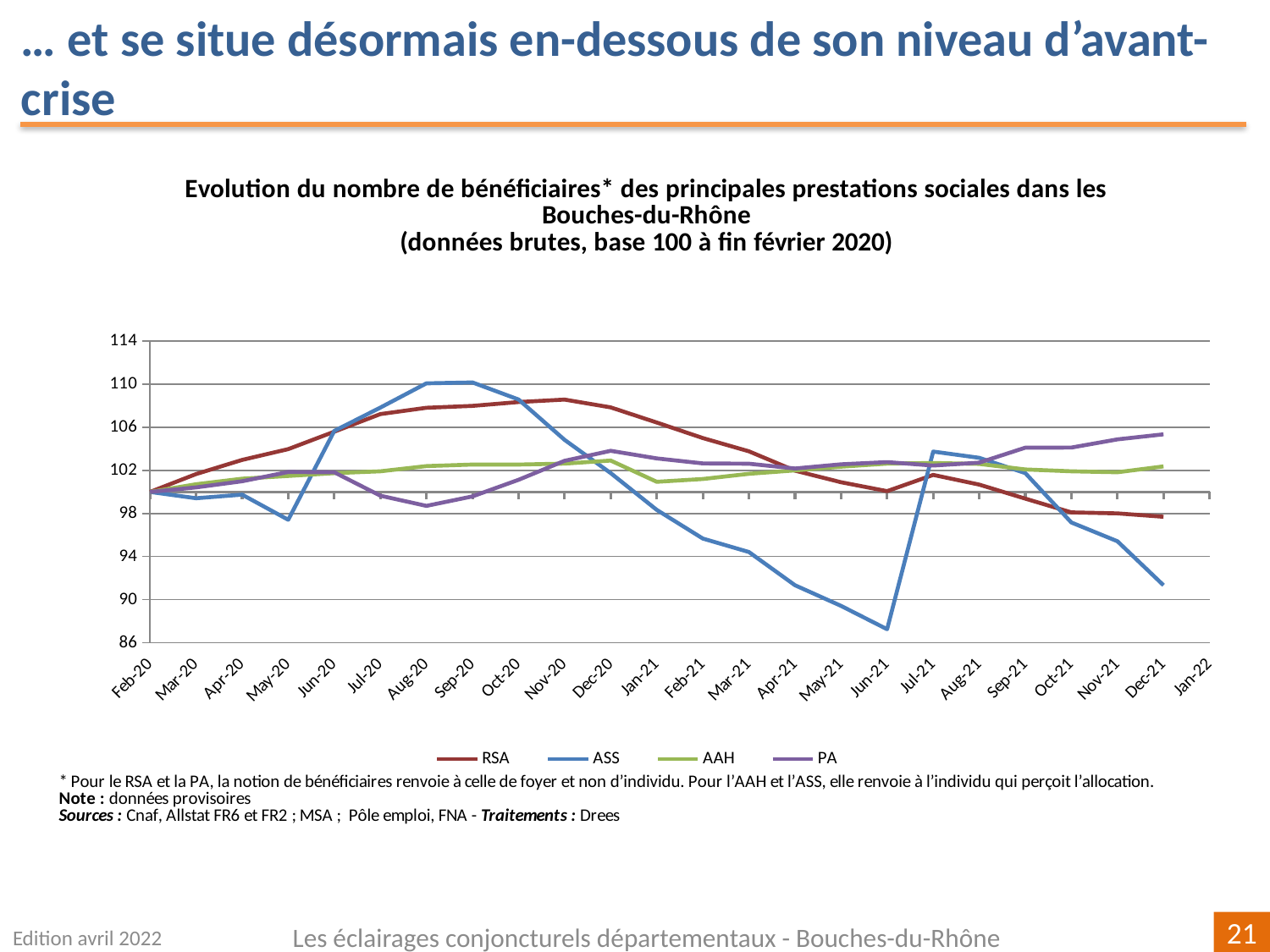
What kind of chart is shown on the slide? line chart How many series does the chart legend list? 4 Which series has the lowest value in Dec-21? ASS Is the value for ASS in Jun-21 greater or less than 90? less Which series has the highest value in Dec-21? PA Is the value for RSA in Dec-21 greater or less than 102? less Is the value for RSA in Nov-20 greater or less than 106? greater Which series reaches the lowest point anywhere on the chart? ASS Which series are listed in the chart legend? RSA, ASS, AAH, PA Does the RSA series rise or fall between Nov-20 and Dec-21? fall